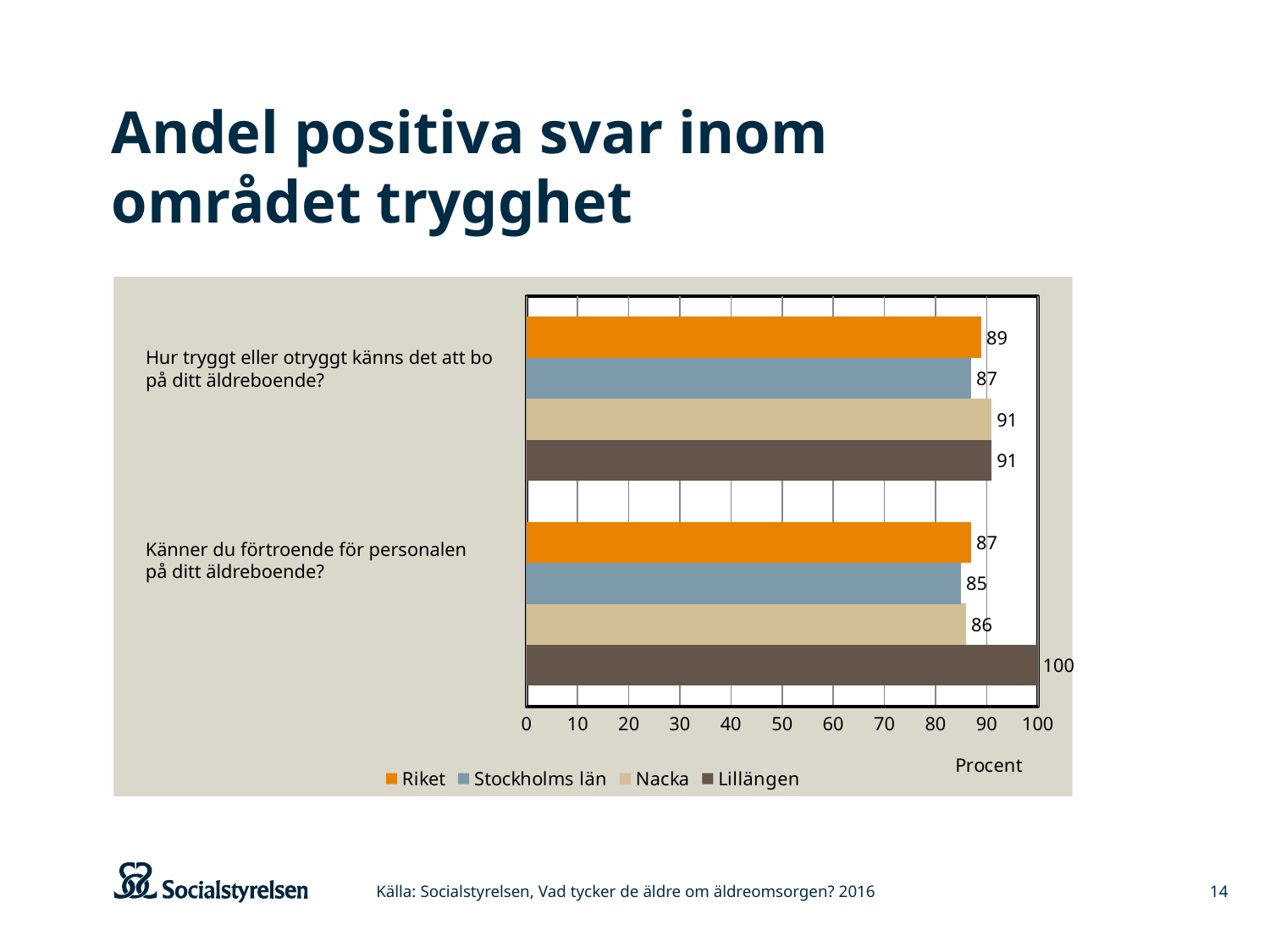
What is the difference between Lillängen and Stockholms län on "Känner du förtroende för personalen på ditt äldreboende?"? 15 What is the value for Lillängen on "Känner du förtroende för personalen på ditt äldreboende?"? 100 What is the value for Nacka on "Hur tryggt eller otryggt känns det att bo på ditt äldreboende?"? 91 What is the value for Stockholms län on "Känner du förtroende för personalen på ditt äldreboende?"? 85 How many question categories are shown on the chart? 2 Which series has the highest value on "Känner du förtroende för personalen på ditt äldreboende?"? Lillängen Which is larger on "Känner du förtroende för personalen på ditt äldreboende?": Riket or Nacka? Riket What is the label of the horizontal axis? Procent What is the value for Riket on "Hur tryggt eller otryggt känns det att bo på ditt äldreboende?"? 89 What kind of chart is shown on the slide? Bar chart Which series has the lowest value on "Hur tryggt eller otryggt känns det att bo på ditt äldreboende?"? Stockholms län How many series does the legend list? 4